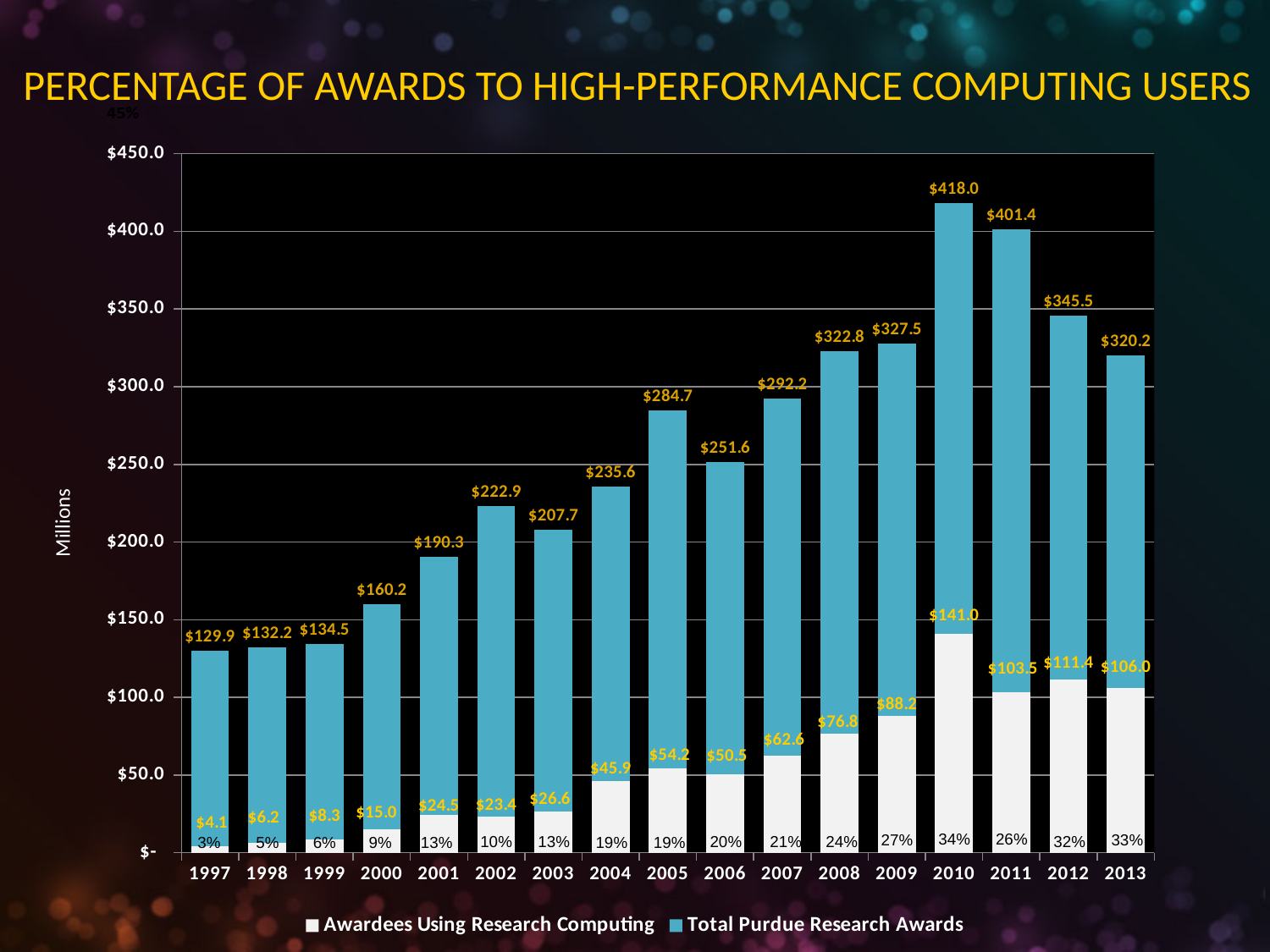
What is the value for Awardees Using Research Computing in 2013? $106.0 Is the value for Total Purdue Research Awards in 2008 greater or less than $300.0? greater How many series does the legend list? 2 What is the label on the vertical axis? Millions What percentage label is shown for 2009? 27% Which year has the lowest value for Awardees Using Research Computing? 1997 What is the difference between Total Purdue Research Awards in 2010 and 2011? $16.6 What kind of chart is shown on the slide? bar chart How many years are shown on the x axis? 17 Which is larger, Total Purdue Research Awards in 2005 or in 2006? 2005 Which year has the highest Total Purdue Research Awards? 2010 What is the value for Total Purdue Research Awards in 2010? $418.0